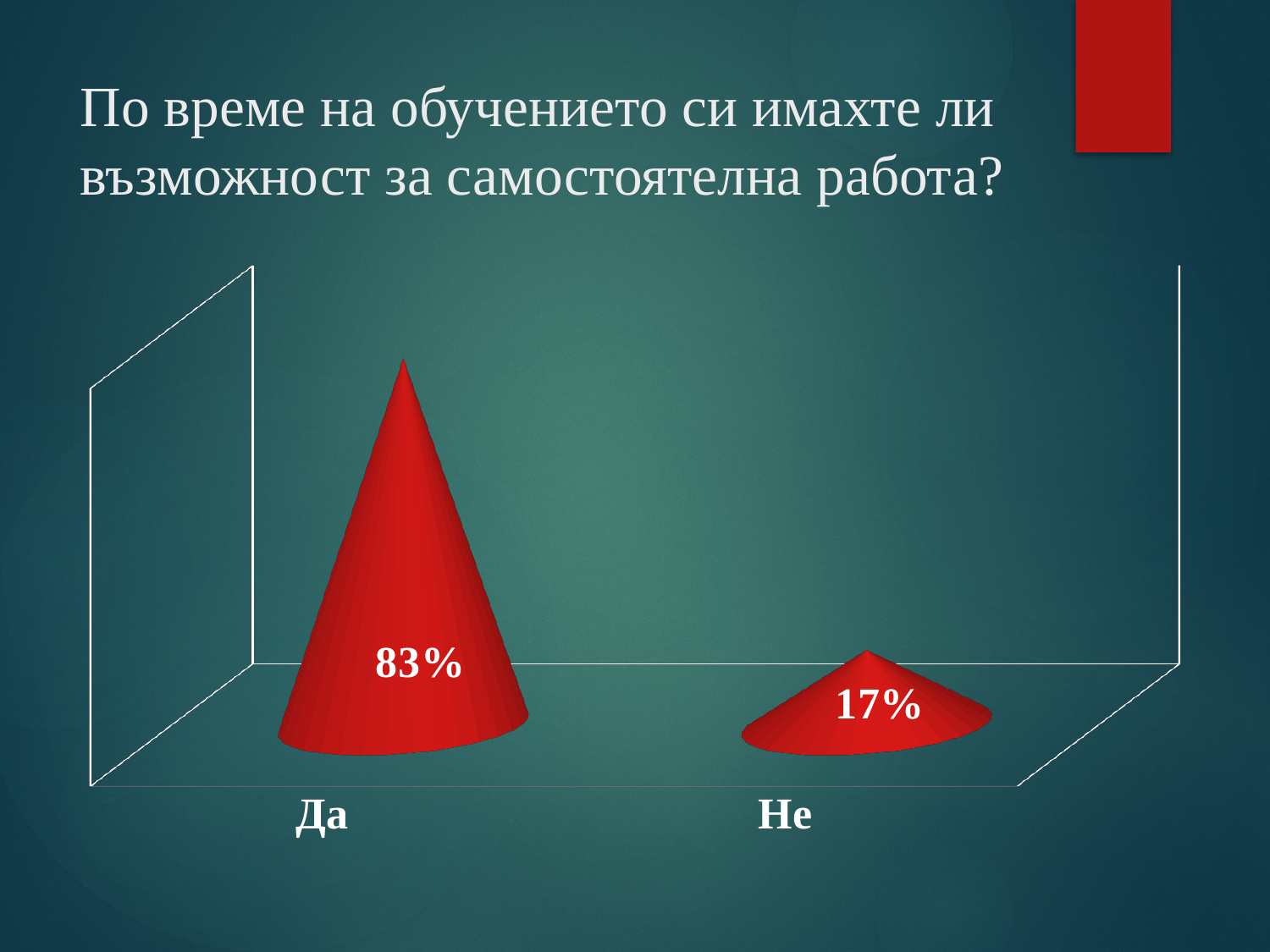
What is the value for Да? 83% What kind of chart is shown on the slide? Bar chart Which category has the highest value? Да What colour are the bars in the chart? Red What is the value for Не? 17% What is the total of the values for Да and Не? 100% Which is larger, the value for Да or the value for Не? Да How many categories are shown in the chart? 2 What is the difference between the values for Да and Не? 66% What is the title of the slide above the chart? По време на обучението си имахте ли възможност за самостоятелна работа? Which category has the lowest value? Не